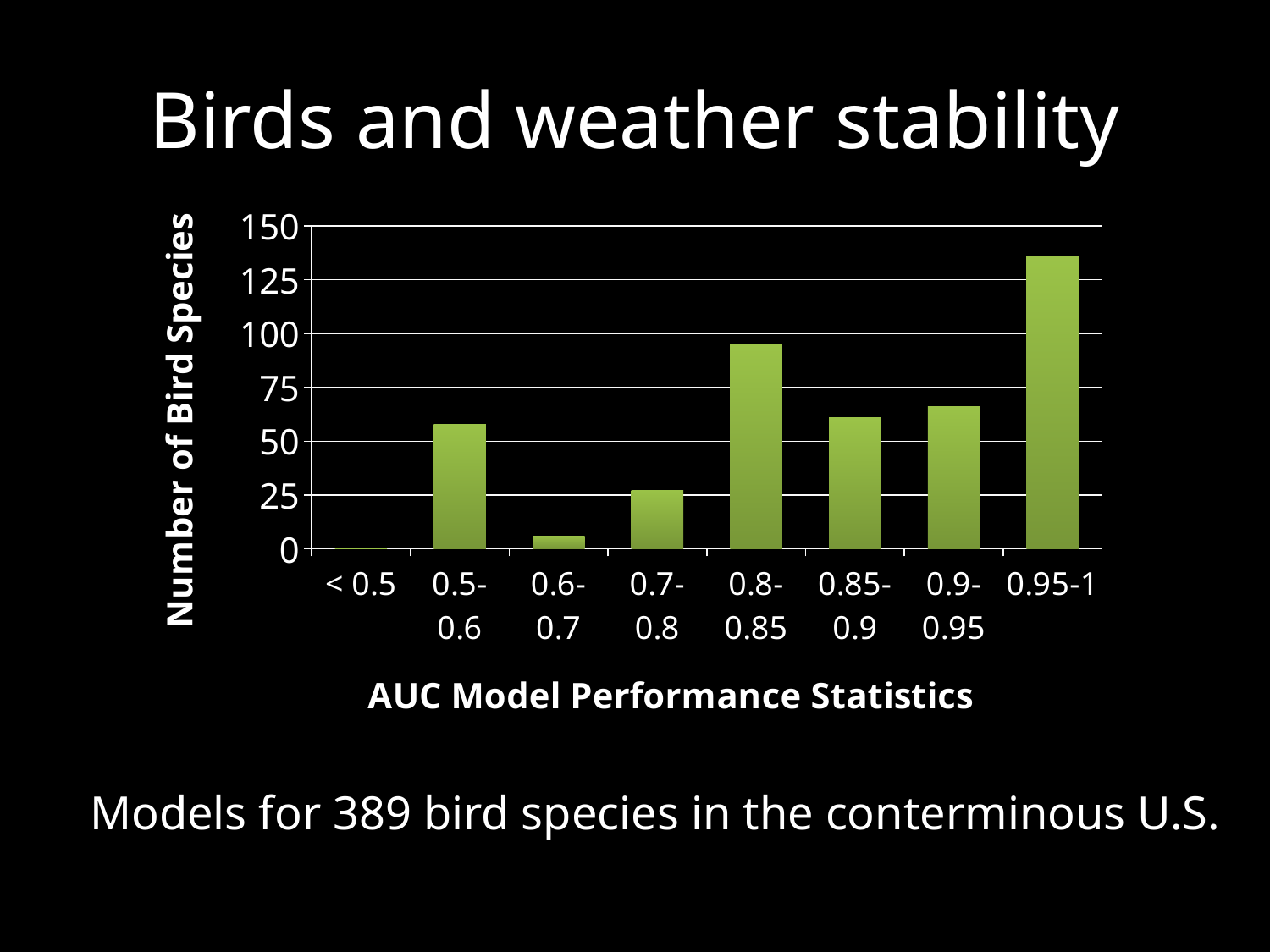
Which has more bird species, the 0.5-0.6 category or the 0.7-0.8 category? 0.5-0.6 Is the number of bird species for 0.95-1 greater or less than 125? greater Is the number of bird species for 0.6-0.7 greater or less than 25? less Is the number of bird species for 0.5-0.6 greater or less than 50? greater How many AUC categories are shown on the x axis? 8 Which has more bird species, the 0.8-0.85 category or the 0.85-0.9 category? 0.8-0.85 Which AUC category has the lowest number of bird species? < 0.5 What kind of chart is shown on the slide? bar chart Which AUC category has the highest number of bird species? 0.95-1 What is the title of the x axis of the chart? AUC Model Performance Statistics